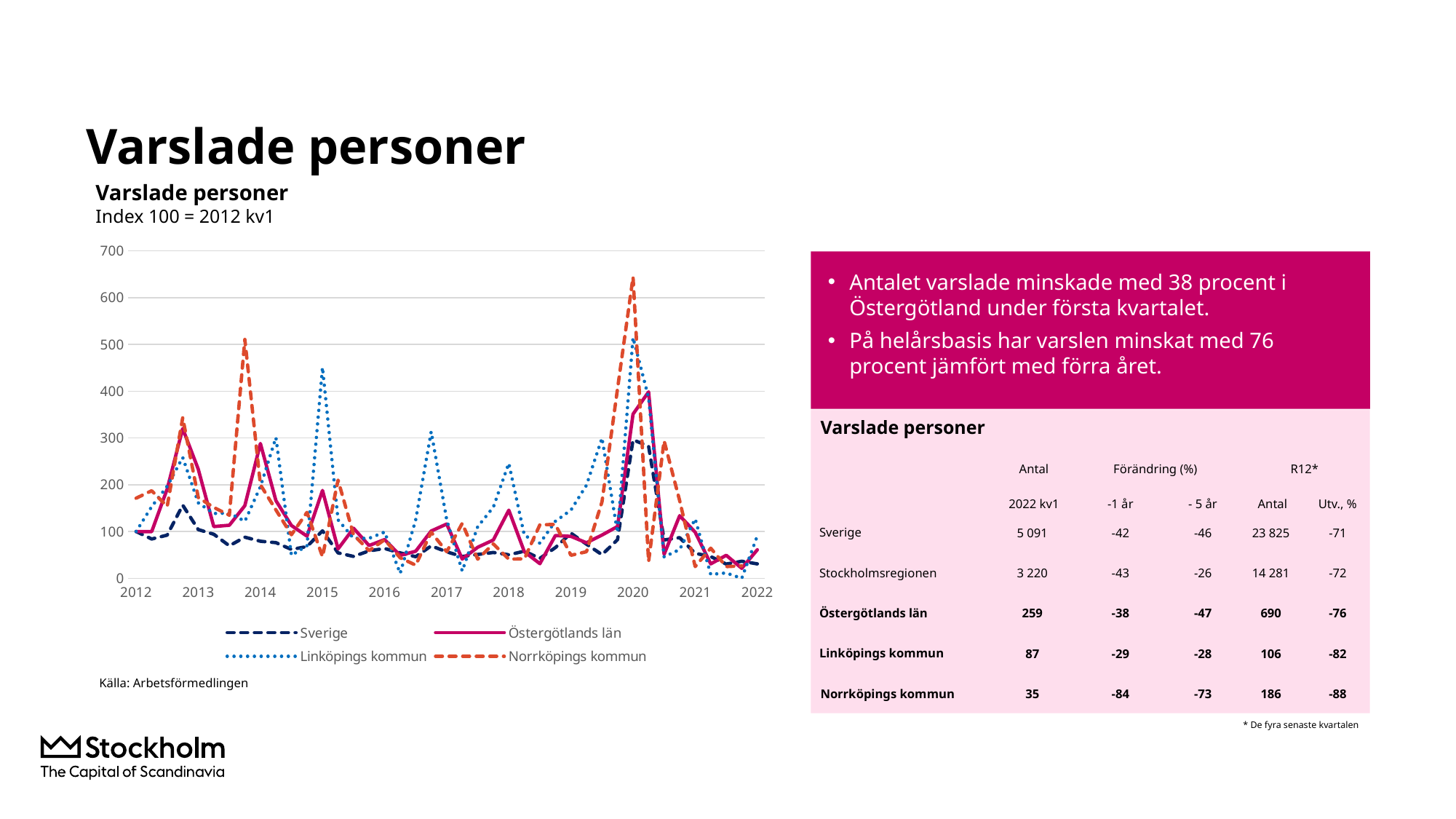
Is the peak value for Sverige in 2020 greater or less than 200? greater How many series does the chart legend list? 4 How many year labels are shown on the x axis? 11 What is the source given below the chart? Arbetsförmedlingen What kind of chart is shown on the slide? line chart At the 2020 peak, which is higher: Norrköpings kommun or Sverige? Norrköpings kommun Is the peak value for Norrköpings kommun in 2020 greater or less than 600? greater Is the peak value for Linköpings kommun in 2015 greater or less than 400? greater Which series has the highest peak in 2015? Linköpings kommun Which series reaches the highest value anywhere on the chart? Norrköpings kommun